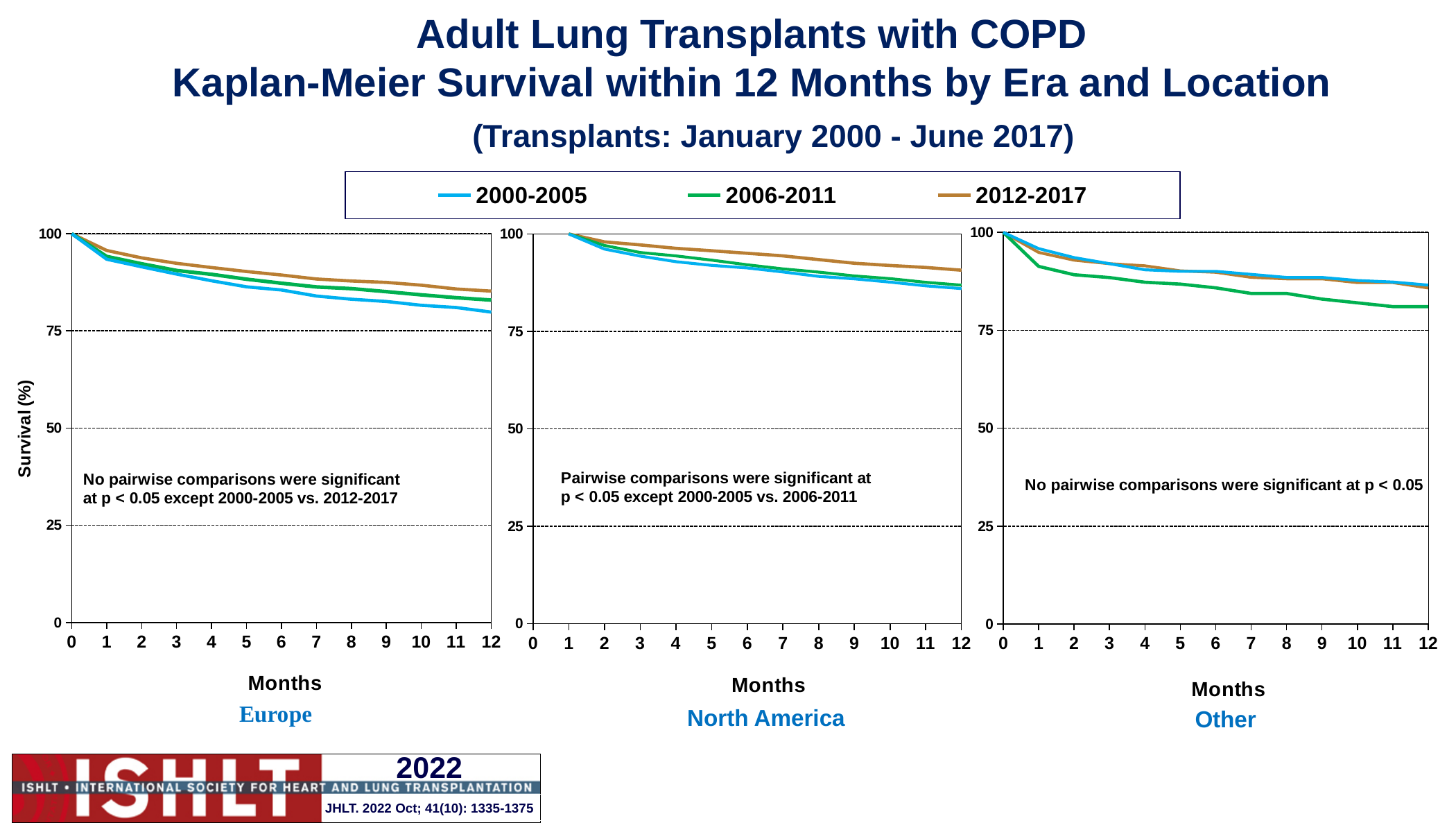
In the Other chart, which era has the lowest survival at 12 months? 2006-2011 How many series does the legend list? 3 What is the label on the y axis of the Europe chart? Survival (%) In the North America chart, which era has the highest survival at 12 months? 2012-2017 How many charts are shown on the slide? 3 In the North America chart, which is larger at 12 months: the value for 2012-2017 or the value for 2000-2005? 2012-2017 In the Europe chart, which era has the highest survival at 12 months? 2012-2017 What kind of chart is the Europe chart? line chart In the Europe chart, which era has the lowest survival at 12 months? 2000-2005 In the Europe chart, do the survival values rise or fall as months increase? fall In the Europe chart, is the value for 2000-2005 at 12 months greater or less than 75? greater In the Other chart, is the value for 2006-2011 at 12 months greater or less than 75? greater